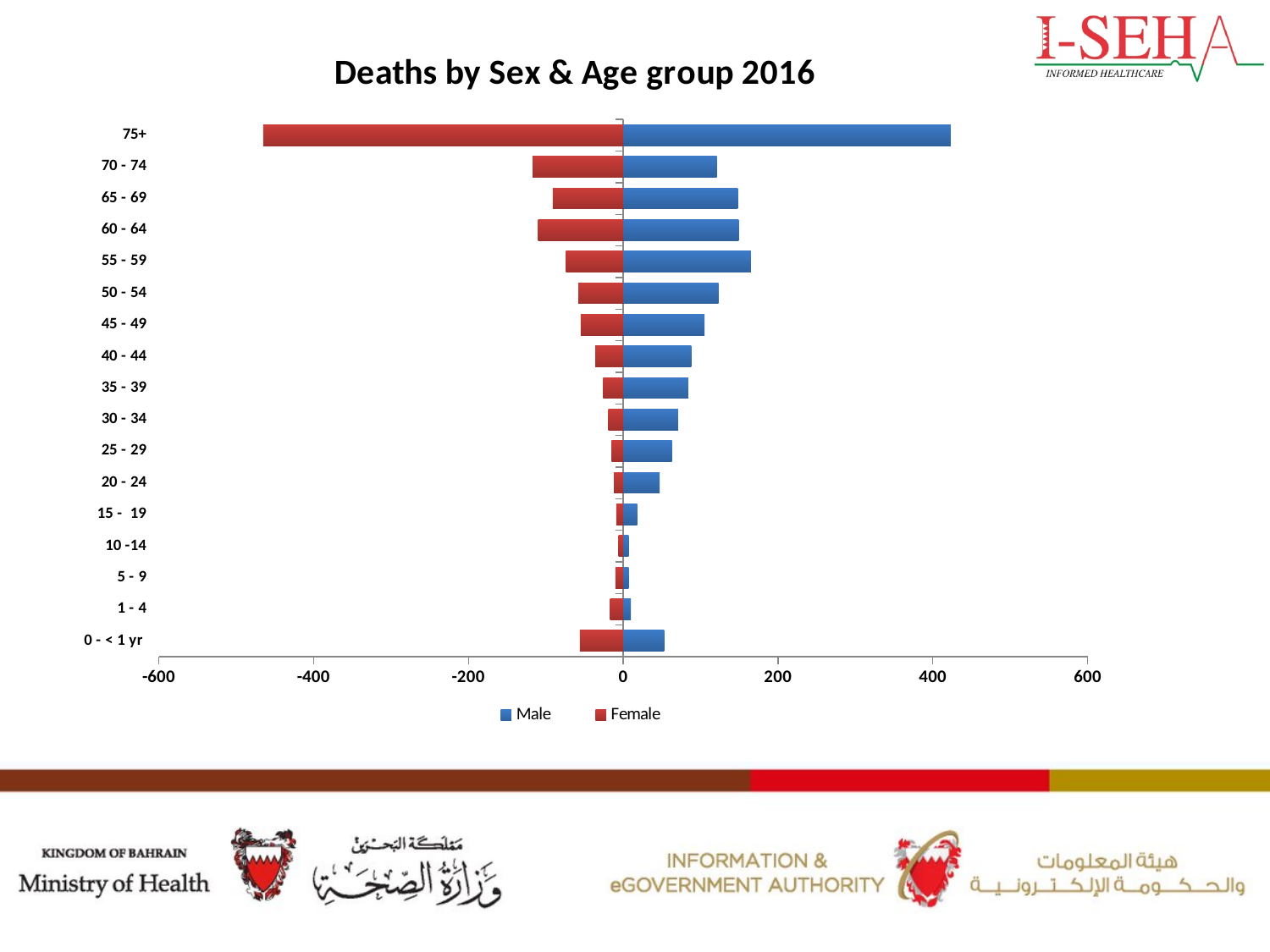
Which is larger, the Male value for 0 - < 1 yr or the Male value for 1 - 4? 0 - < 1 yr Is the Male value for the 70 - 74 age group greater or less than 200? less Which age group has the longest Female bar? 75+ What is the title of the chart? Deaths by Sex & Age group 2016 Is the Male value for the 75+ age group greater or less than 400? greater Is the Male value for the 55 - 59 age group greater or less than 200? less Which is larger, the Male value for 55 - 59 or the Male value for 70 - 74? 55 - 59 Which colour represents the Female series in the chart? red Which age group has the highest number of Male deaths? 75+ What kind of chart is shown on the slide? bar chart How many series does the legend list? 2 How many age group categories are plotted on the chart? 17